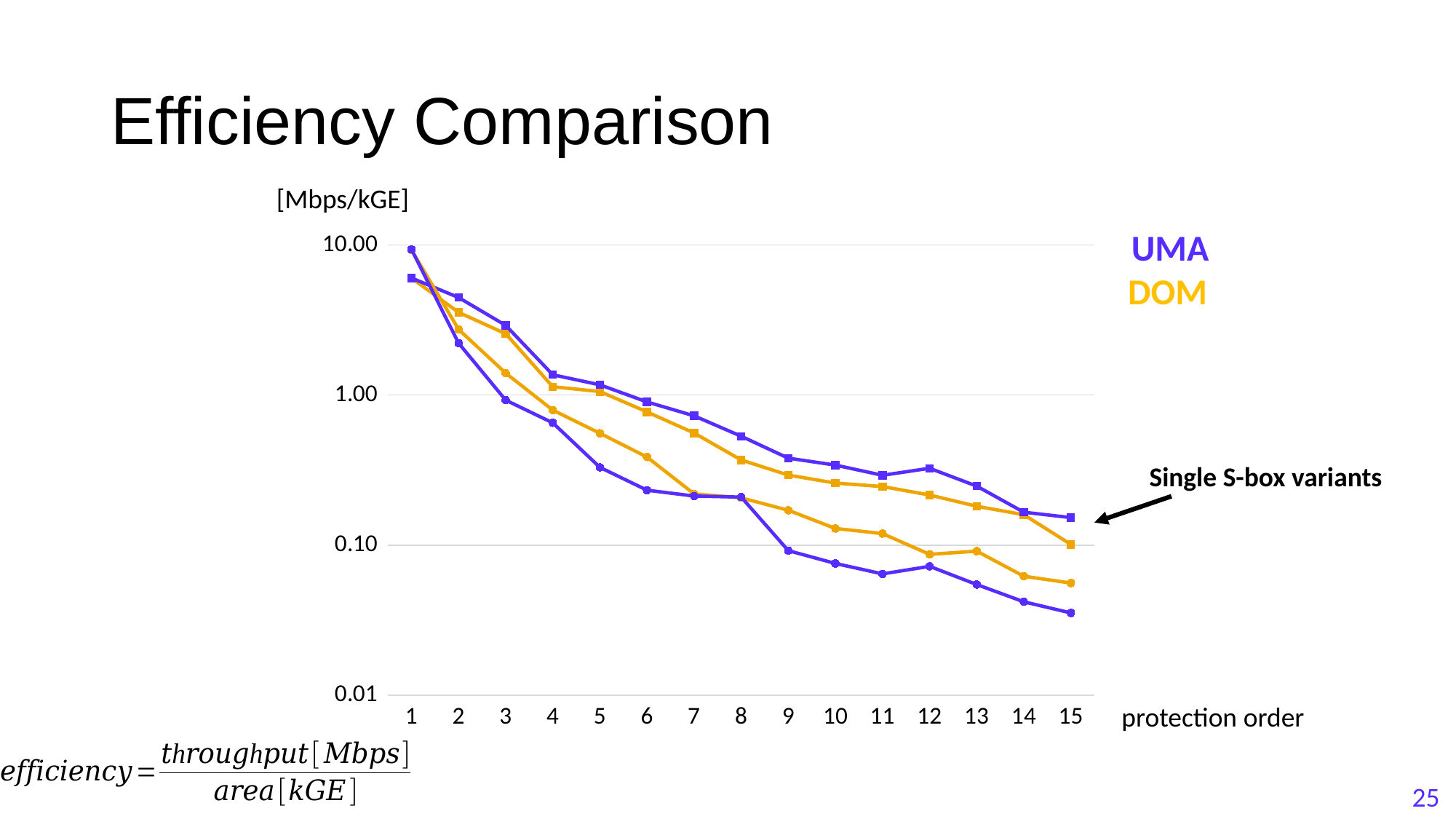
Is the value of the DOM line with circle markers at protection order 8 greater or less than 0.10? greater At protection order 15, which single S-box variant has the higher efficiency, UMA or DOM? UMA Is the value of the UMA single S-box variant at protection order 15 greater or less than 0.10? greater Is the value of the UMA single S-box variant at protection order 5 greater or less than 1.00? greater What kind of chart is shown on the slide? line chart How many lines are plotted in the chart? 4 What unit is shown for the y axis? [Mbps/kGE] Which colour represents DOM in the chart? orange How many entries does the legend list? 2 How many protection order values are plotted along the x axis? 15 Do the efficiency values rise or fall as the protection order increases? fall